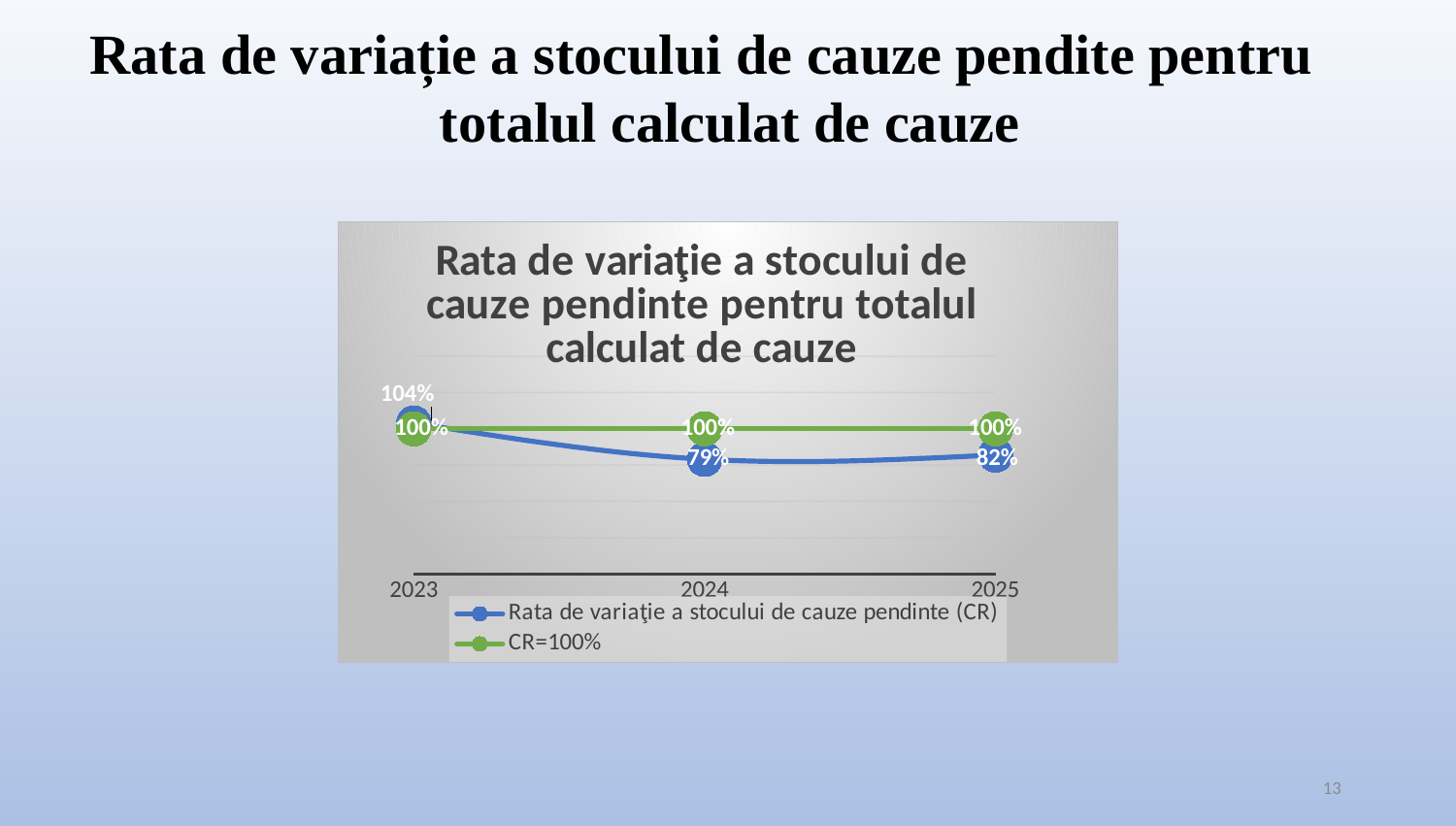
What type of chart is shown on the slide? line chart What is the difference between the 2023 and 2024 values of 'Rata de variaţie a stocului de cauze pendinte (CR)'? 25% What is the value of 'Rata de variaţie a stocului de cauze pendinte (CR)' in 2024? 79% What is the value of 'Rata de variaţie a stocului de cauze pendinte (CR)' in 2025? 82% How many years are shown on the x axis? 3 In which year is 'Rata de variaţie a stocului de cauze pendinte (CR)' highest? 2023 Which is larger for 'Rata de variaţie a stocului de cauze pendinte (CR)': the 2024 value or the 2025 value? 2025 What is the value of the 'CR=100%' series in 2024? 100% In which year is 'Rata de variaţie a stocului de cauze pendinte (CR)' lowest? 2024 What colour is the line for the 'CR=100%' series? green How many series does the legend list? 2 What is the value of 'Rata de variaţie a stocului de cauze pendinte (CR)' in 2023? 104%